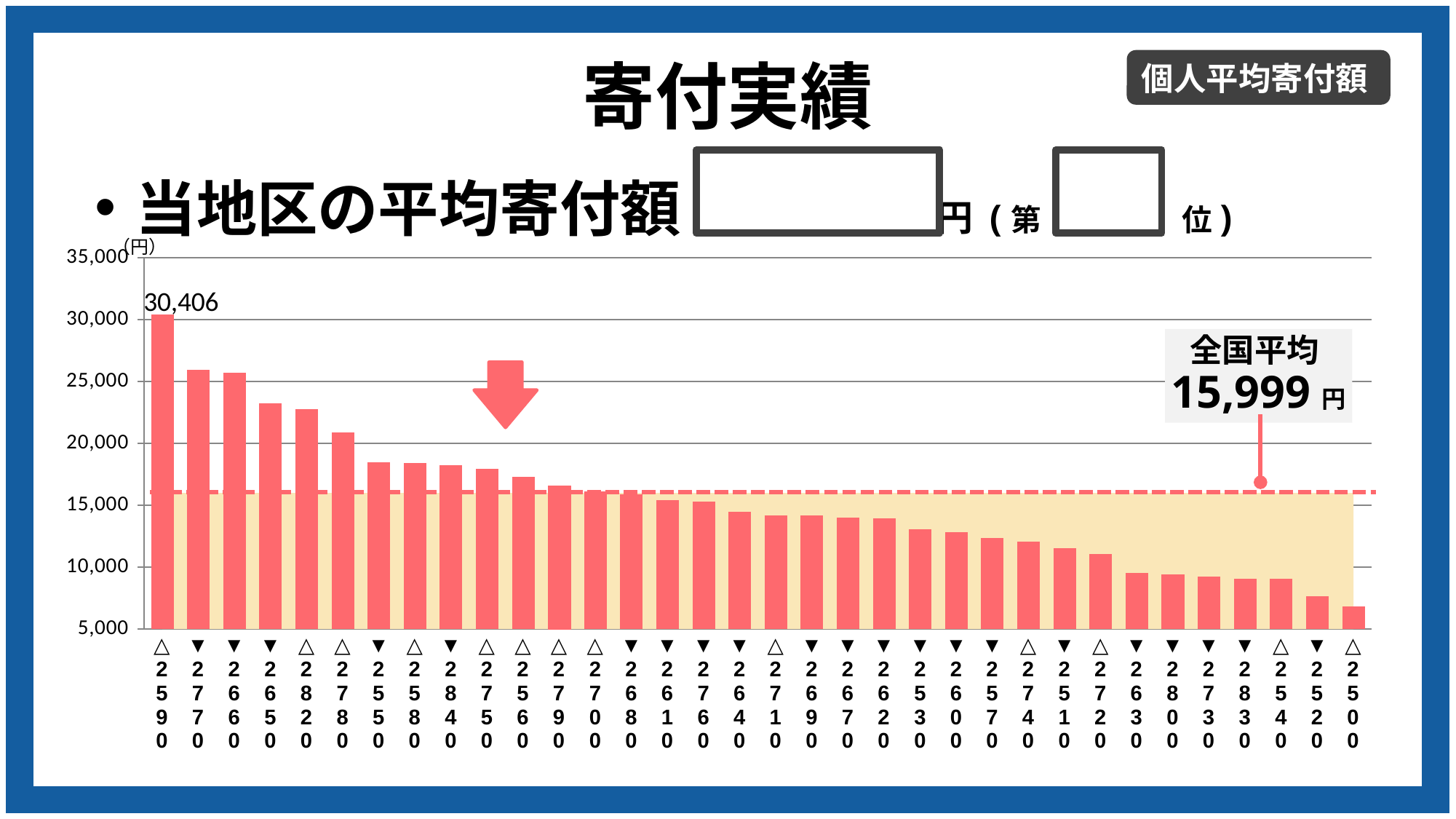
Which has the larger value, 2590 or 2770? 2590 Which category has the highest bar in the chart? 2590 How many bars (categories) are plotted in the chart? 34 Do the bar values rise or fall from left to right along the x axis? fall Is the value for 2770 greater or less than 25,000? greater What kind of chart is shown on the slide? bar chart Which category has the lowest bar in the chart? 2500 Is the value for 2780 greater or less than 20,000? greater Is the value for 2650 greater or less than 25,000? less What is the value printed above the first bar (2590) in the chart? 30,406 What national average (全国平均) value is shown next to the dashed line on the chart? 15,999円